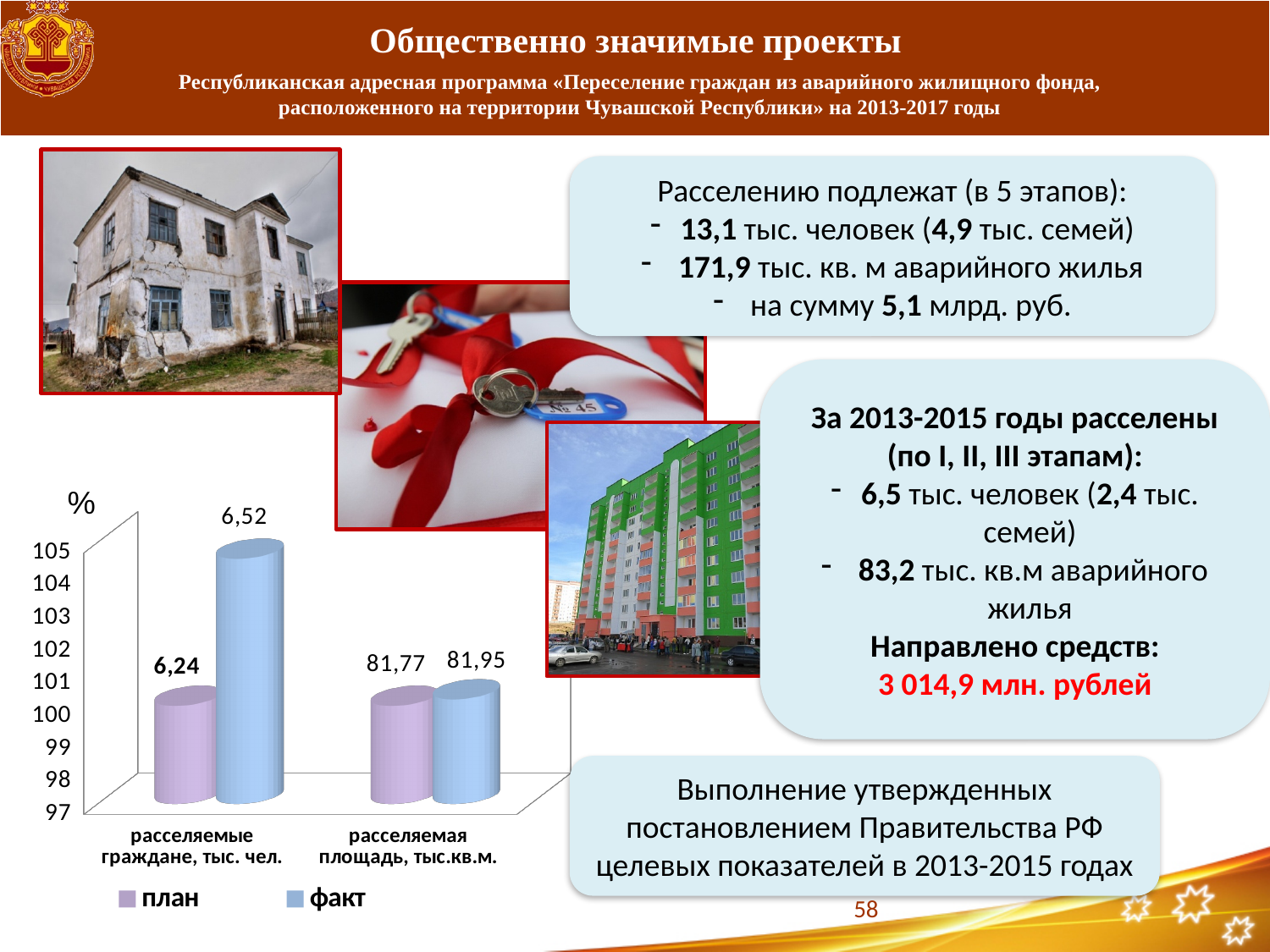
What is the план value for расселяемые граждане, тыс. чел.? 6,24 What type of chart is shown on the slide? bar chart By how much does the факт value exceed the план value for расселяемая площадь, тыс.кв.м.? 0,18 For расселяемые граждане, тыс. чел., which series has the larger value, план or факт? факт How many series does the chart legend list? 2 By how much does the факт value exceed the план value for расселяемые граждане, тыс. чел.? 0,28 What is the факт value for расселяемая площадь, тыс.кв.м.? 81,95 On the % axis, is the факт bar for расселяемые граждане greater or less than 103? greater What is the план value for расселяемая площадь, тыс.кв.м.? 81,77 What are the two series named in the chart legend? план, факт How many categories are shown on the x axis of the chart? 2 What is the факт value for расселяемые граждане, тыс. чел.? 6,52